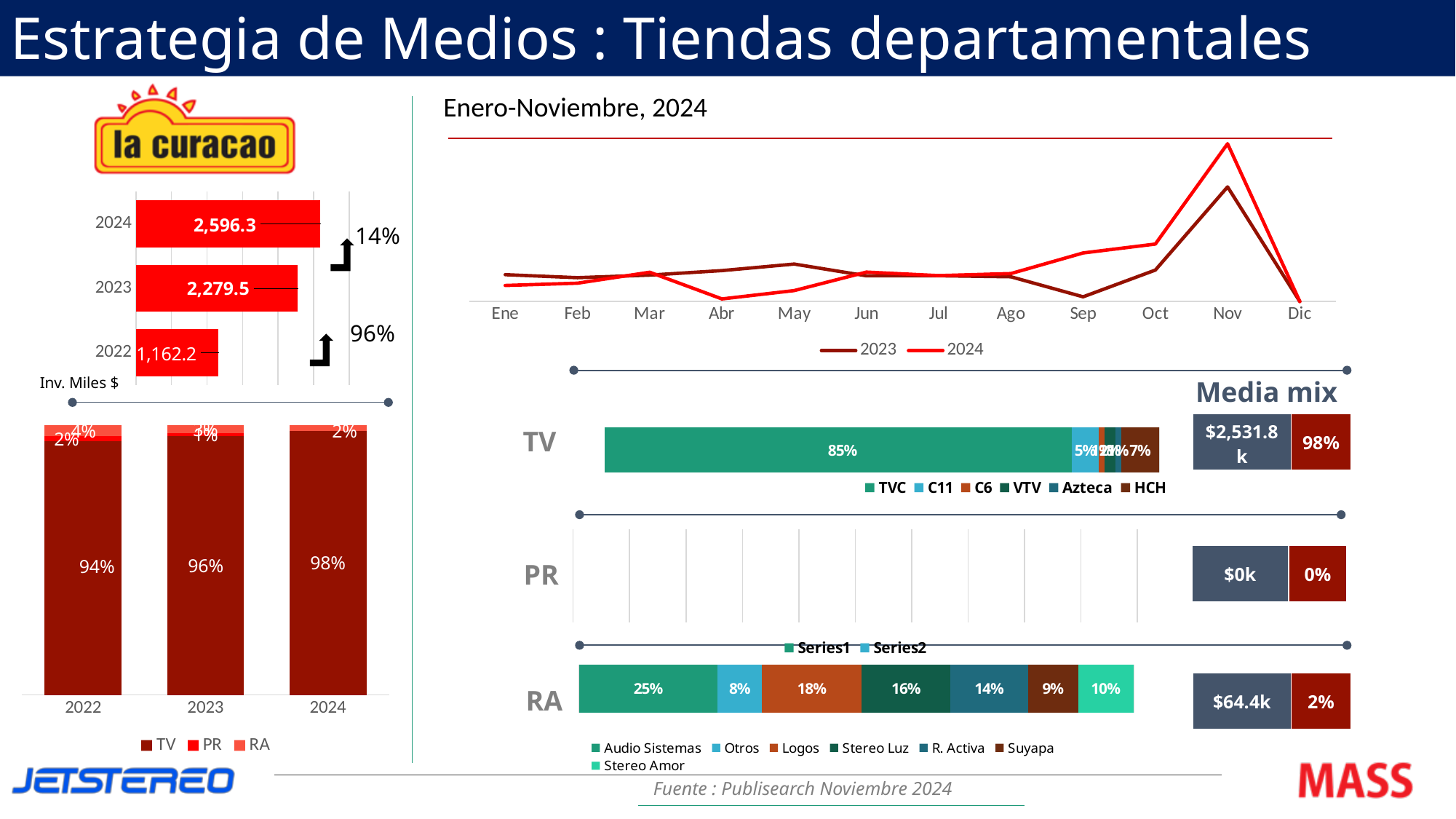
In the Media mix boxes on the right, what is the amount shown for RA? $64.4k In the top-left bar chart of investment by year, what is the difference between the 2024 and 2023 values? 316.8 What kind of chart is the top-left chart showing investment by year? bar chart In the top-left bar chart of investment by year, what is the value for 2022? 1,162.2 In the bottom-left stacked bar chart of TV, PR and RA shares, what is the TV share for 2024? 98% In the RA stacked bar chart, which is larger, Stereo Luz or R. Activa? Stereo Luz In the line chart for Enero-Noviembre 2024, how many series does the legend list? 2 In the top-left bar chart of investment by year, which year has the highest value? 2024 In the line chart for Enero-Noviembre 2024, in which month does the 2024 line reach its highest point? Nov In the RA stacked bar chart, what is the share for Audio Sistemas? 25% In the top-left bar chart of investment by year (Inv. Miles $), what is the value for 2024? 2,596.3 In the bottom-left stacked bar chart of TV, PR and RA shares, what is the RA share for 2022? 4%